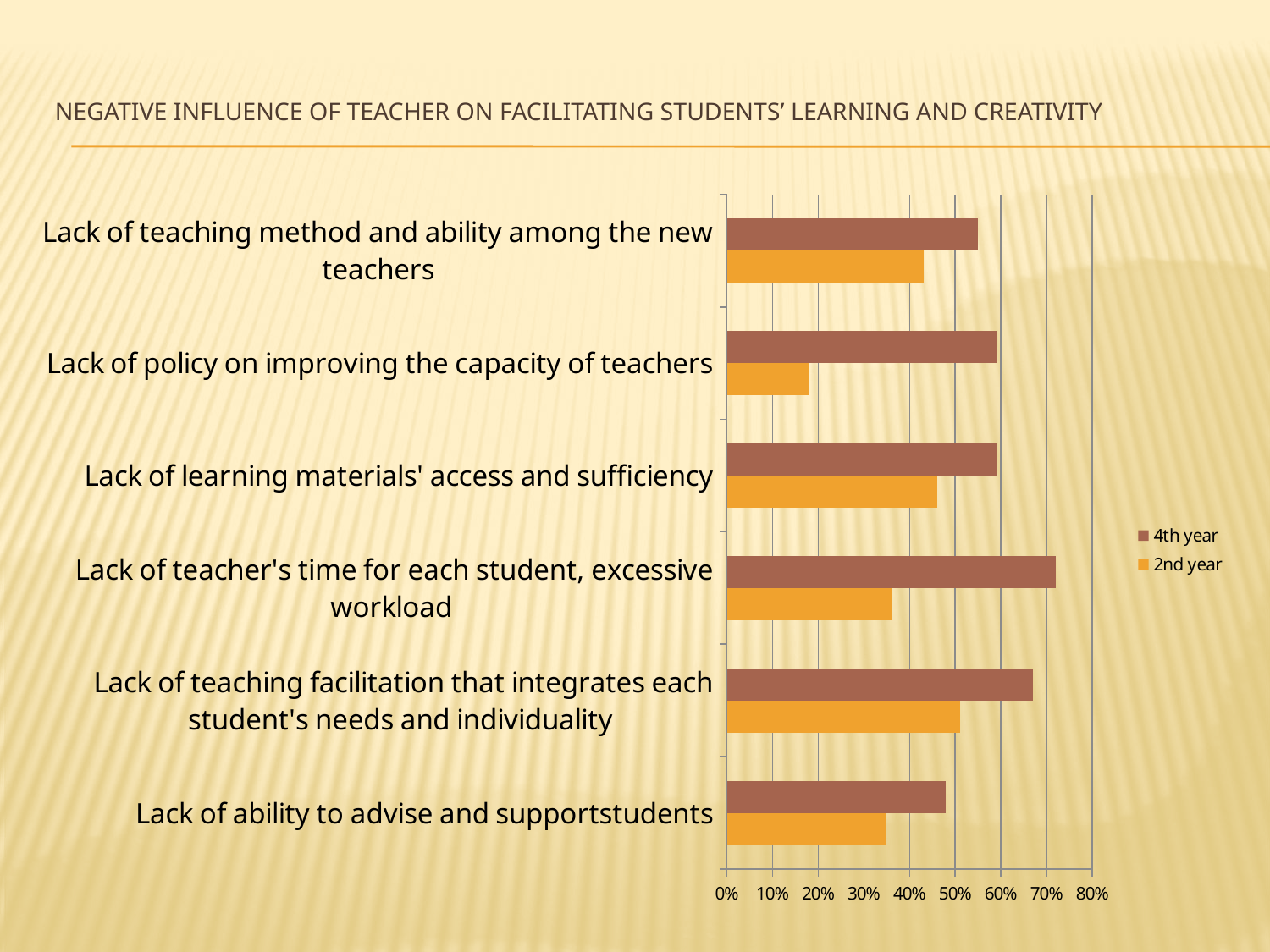
How many categories are plotted on the chart? 6 Which series is shown in orange in the legend? 2nd year Which category has the lowest value for the 4th year series? Lack of ability to advise and supportstudents Is the 4th year value for 'Lack of ability to advise and supportstudents' greater or less than 50%? less For 'Lack of learning materials' access and sufficiency', which series has the larger value, 4th year or 2nd year? 4th year Which category has the lowest value for the 2nd year series? Lack of policy on improving the capacity of teachers How many series does the legend list? 2 Is the 2nd year value for 'Lack of policy on improving the capacity of teachers' greater or less than 20%? less Which category has the highest value for the 4th year series? Lack of teacher's time for each student, excessive workload What kind of chart is shown on the slide? bar chart Is the 4th year value for 'Lack of teacher's time for each student, excessive workload' greater or less than 70%? greater